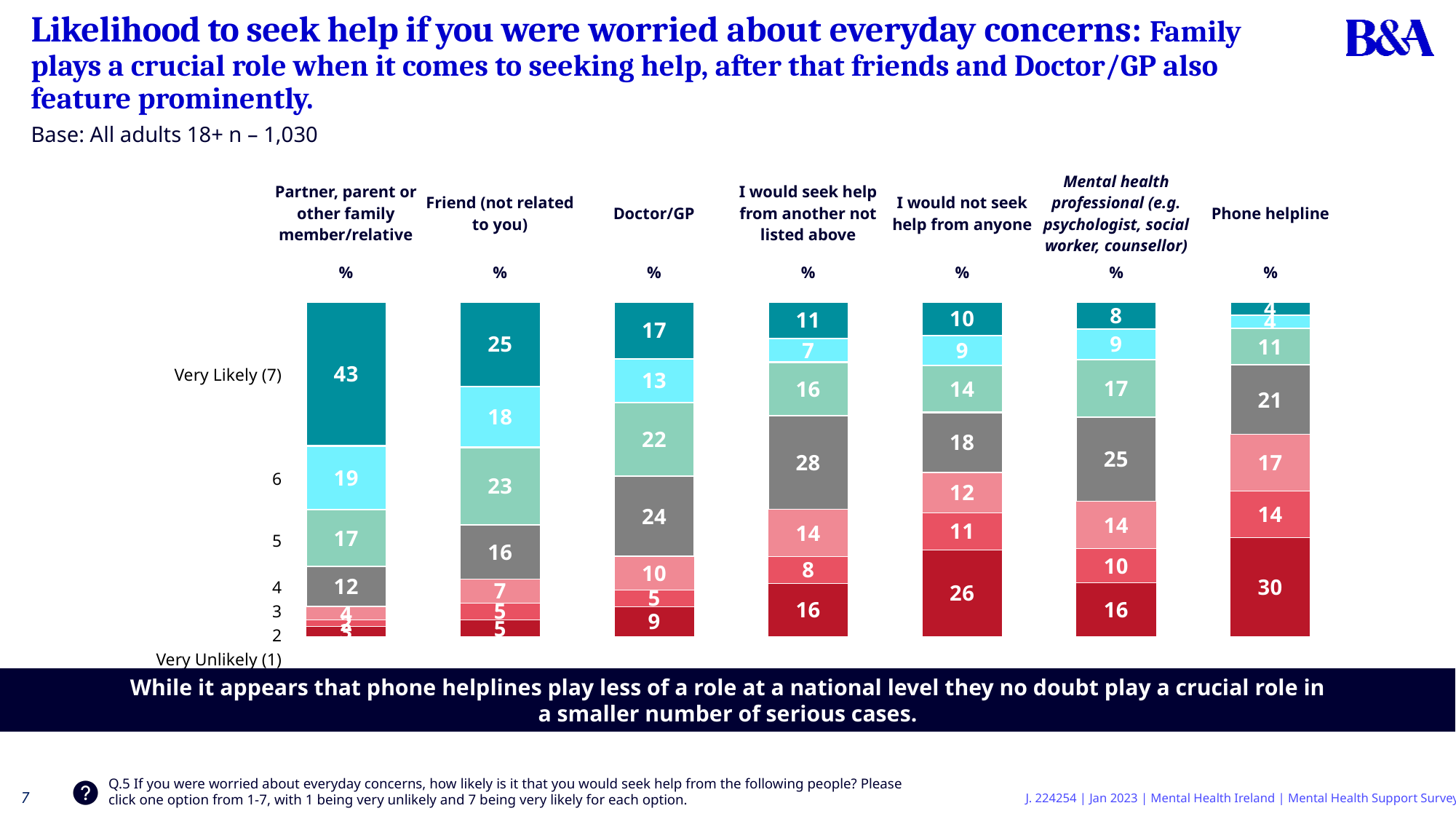
Which source of help has the highest Very Likely (7) percentage? Partner, parent or other family member/relative Which source of help has the lowest Very Likely (7) percentage? Phone helpline What is the total of all the segments in the Doctor/GP bar? 100 What percentage of respondents gave a rating of 4 for a mental health professional (e.g. psychologist, social worker, counsellor)? 25 What percentage of respondents are Very Likely (7) to seek help from a partner, parent or other family member/relative? 43 How many sources of help are shown as bars in the chart? 7 What percentage of respondents are Very Unlikely (1) to seek help from a phone helpline? 30 What type of chart is used on this slide? Stacked bar chart Which has a larger percentage at rating 4: Doctor/GP or Friend (not related to you)? Doctor/GP What percentage of respondents are Very Unlikely (1) to seek help from anyone? 26 What is the difference between the Very Likely (7) percentage for Friend (not related to you) and for Doctor/GP? 8 What is the base sample size stated for the chart? All adults 18+ n – 1,030